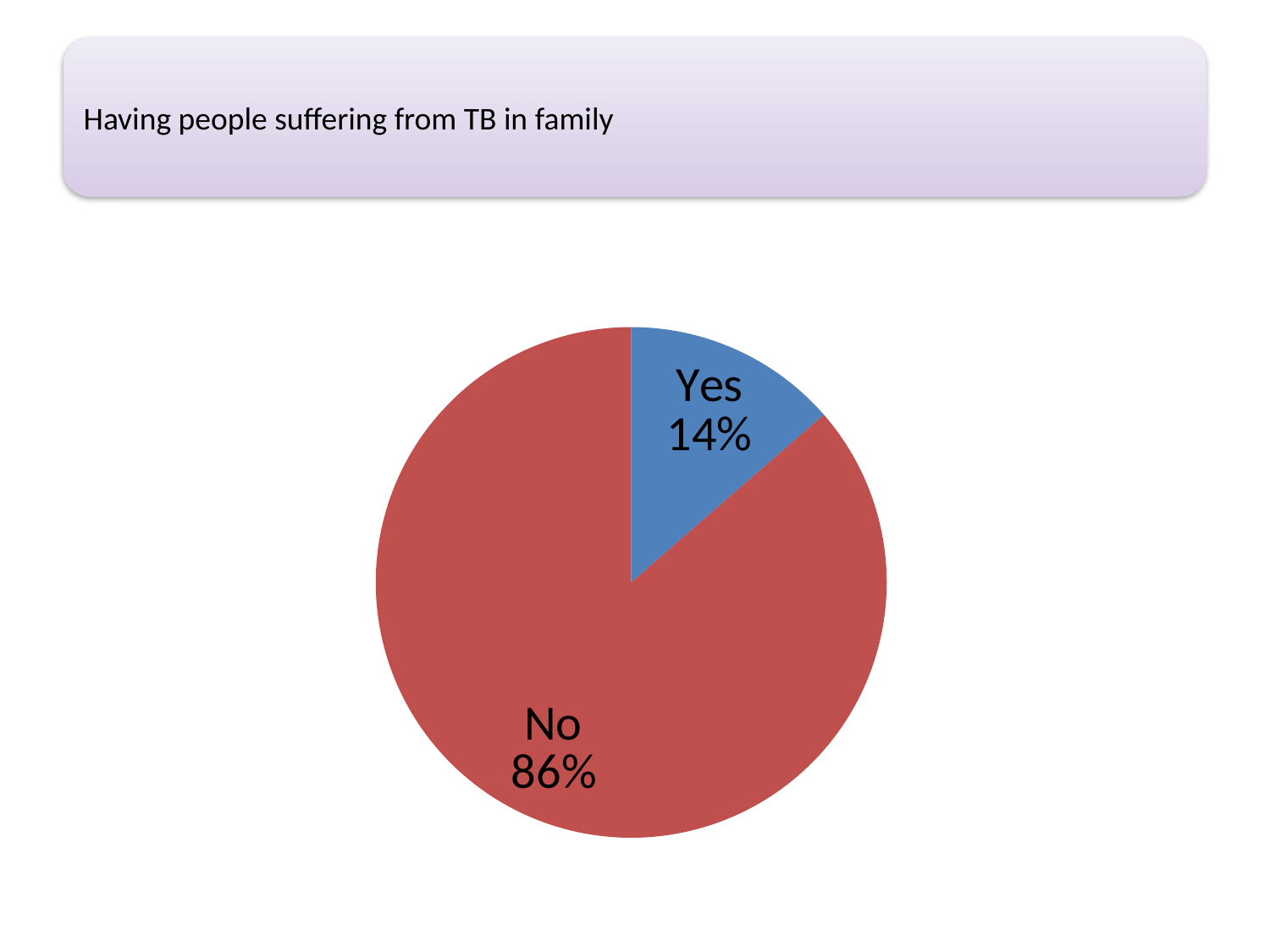
Which category has the smallest share of the pie? Yes What share of the pie does the "Yes" slice represent? 14% What is the title shown above the chart? Having people suffering from TB in family What is the difference in percentage points between the "No" and "Yes" slices? 72 What percentage of respondents answered "Yes" to having people suffering from TB in the family? 14% Which category has the largest share of the pie? No What type of chart is shown on the slide? pie chart What percentage of respondents answered "No"? 86% How many slices does the pie chart have? 2 What colour is the "No" slice? red Which slice is larger, "Yes" or "No"? No